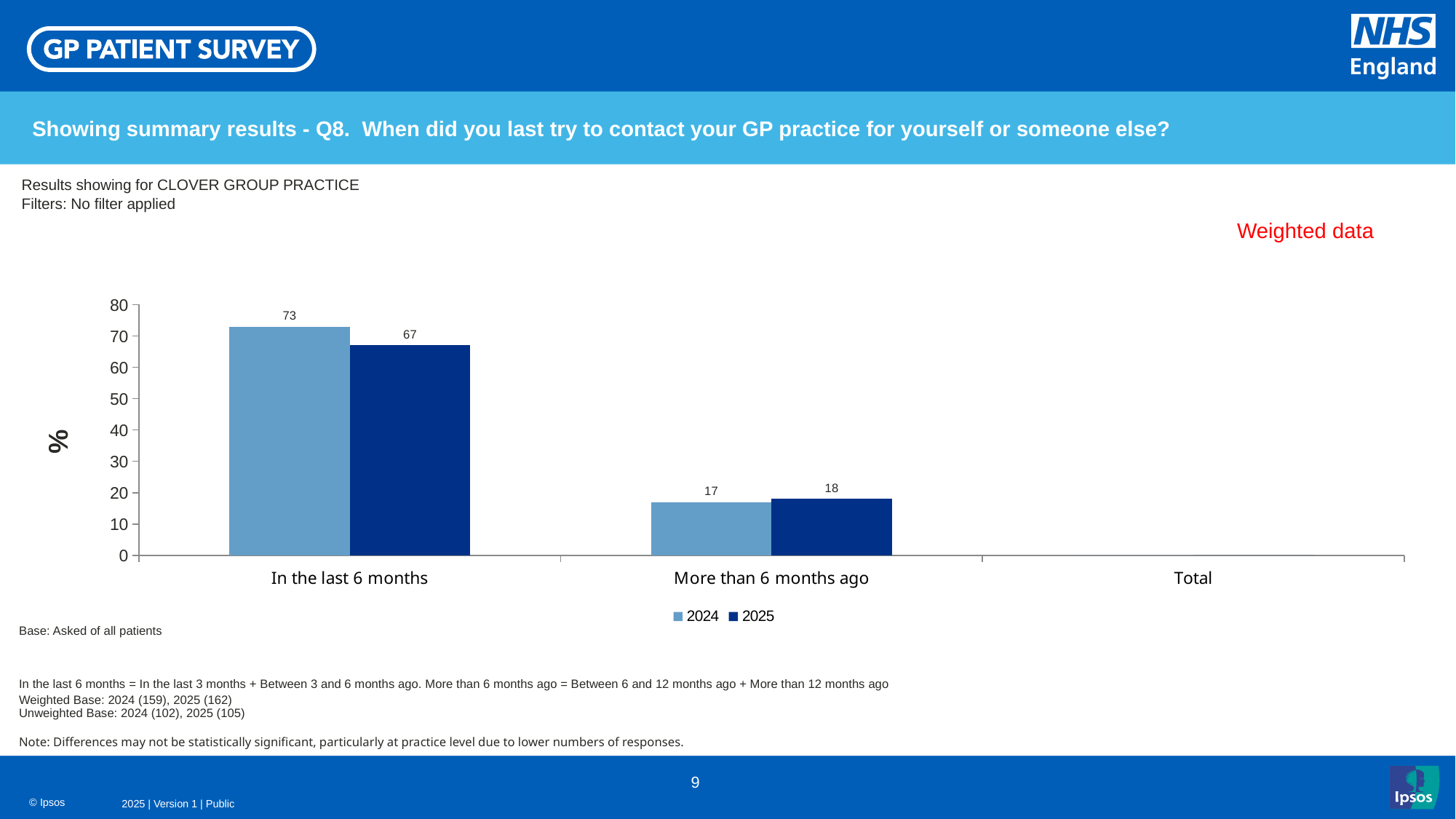
What is the 2024 value for 'In the last 6 months'? 73 What kind of chart is shown on the slide? Bar chart Is the 2025 value for 'In the last 6 months' greater or less than 60? greater What is the label on the vertical axis? % How many series does the legend list? 2 Which category has the highest 2025 value? In the last 6 months What is the 2025 value for 'In the last 6 months'? 67 Which is larger for 'In the last 6 months': the 2024 value or the 2025 value? 2024 What is the difference between the 2024 and 2025 values for 'In the last 6 months'? 6 Which series is shown in the darker blue colour? 2025 What is the 2024 value for 'More than 6 months ago'? 17 What is the 2025 value for 'More than 6 months ago'? 18